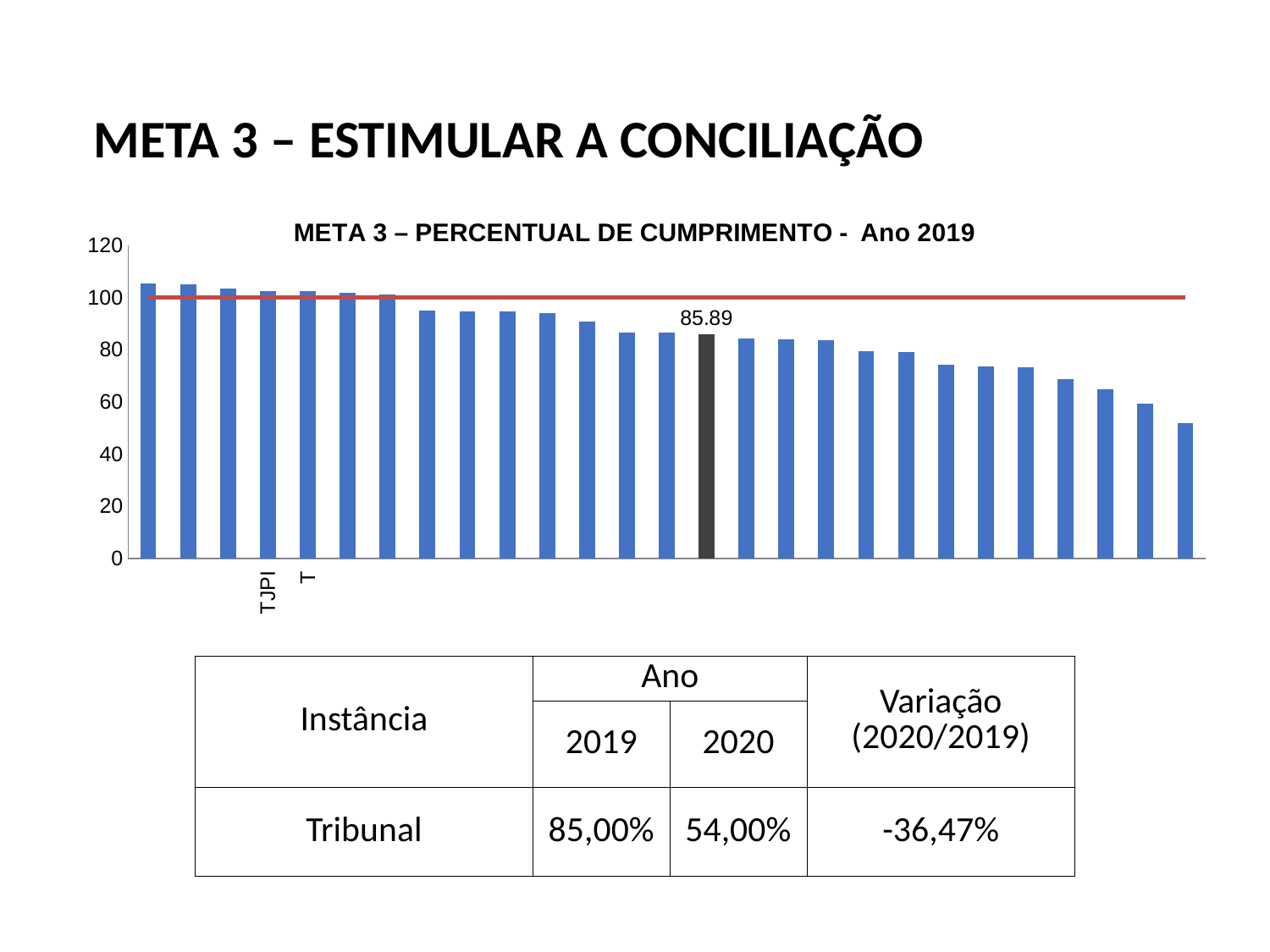
Is the value of the rightmost bar greater or less than 60? less How many bars are plotted in the chart? 27 What value is printed on the dark grey highlighted bar? 85.89 Which is larger, the leftmost bar or the rightmost bar? the leftmost bar What is the title of the chart? META 3 – PERCENTUAL DE CUMPRIMENTO - Ano 2019 Is the value of the dark grey highlighted bar greater or less than 80? greater At what level on the y axis is the red horizontal line drawn? 100 Is the value of the dark grey highlighted bar greater or less than 100? less Which bar is the lowest in the chart? the rightmost bar Do the bar values rise or fall from left to right along the x axis? fall What kind of chart is shown on the slide? bar chart